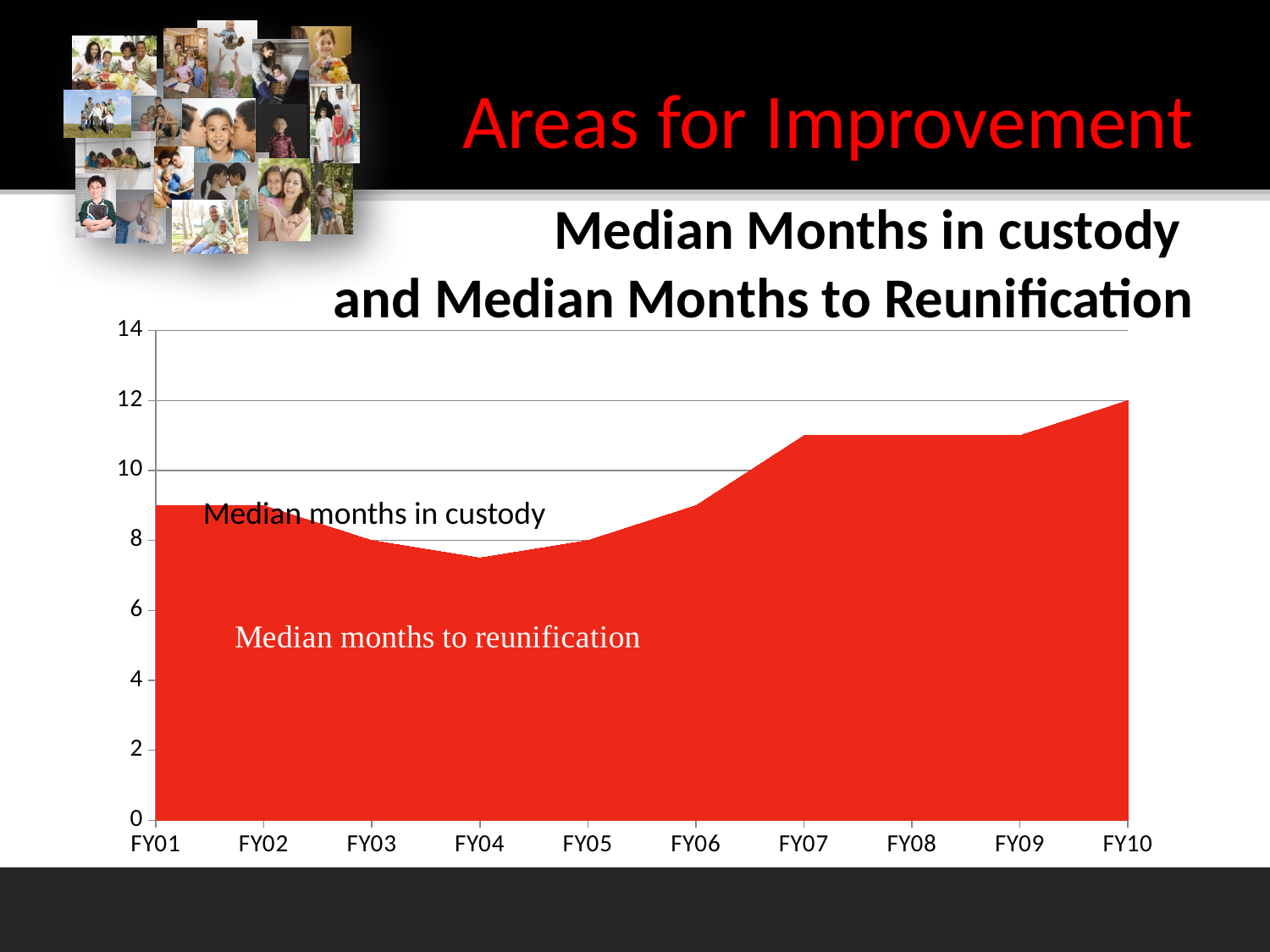
Which fiscal year has the lowest value in the chart? FY04 Is the value for FY01 greater or less than 8? greater Which fiscal year has the highest value in the chart? FY10 Do the values rise or fall from FY04 to FY10? rise Is the value for FY04 greater or less than 8? less What type of chart is shown on the slide? Area chart Which is larger, the value for FY07 or the value for FY02? FY07 Is the value for FY07 greater or less than 10? greater How many fiscal years are shown on the x axis of the chart? 10 What is the value for FY10 in the chart? 12 What is the title of the chart? Median Months in custody and Median Months to Reunification